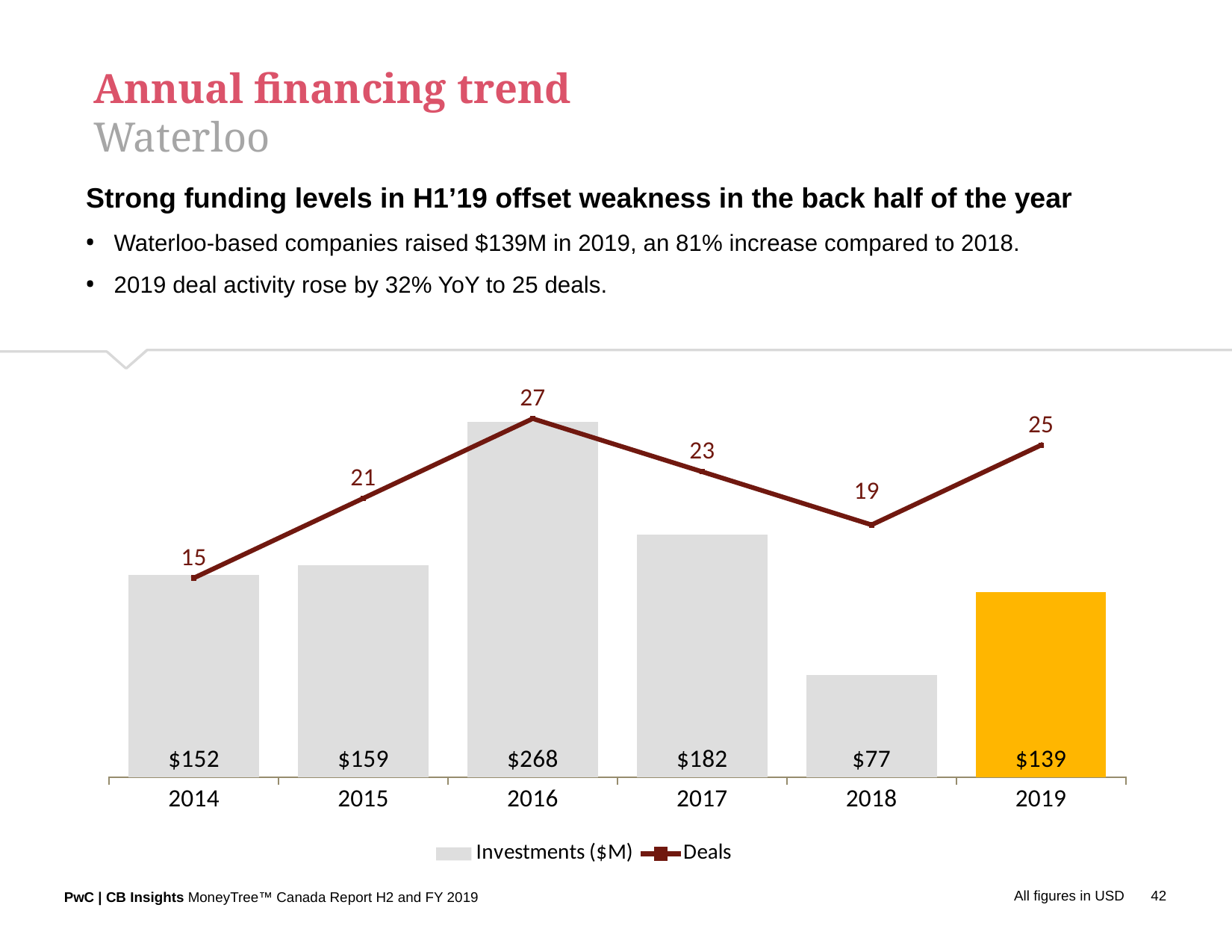
Did Investments ($M) rise or fall from 2017 to 2018? Fall What is the difference in Investments ($M) between 2019 and 2018? $62 How many series does the legend list? 2 Which year had more Deals, 2017 or 2019? 2019 What kind of chart is used to show Investments ($M)? Bar chart Which bar is coloured differently from the others? 2019 What was the value of Investments ($M) in 2016? $268 Which year had the lowest number of Deals? 2014 Which year had the highest Investments ($M)? 2016 How many years are shown on the x axis? 6 What is the difference in Deals between 2016 and 2015? 6 How many Deals were there in 2018? 19